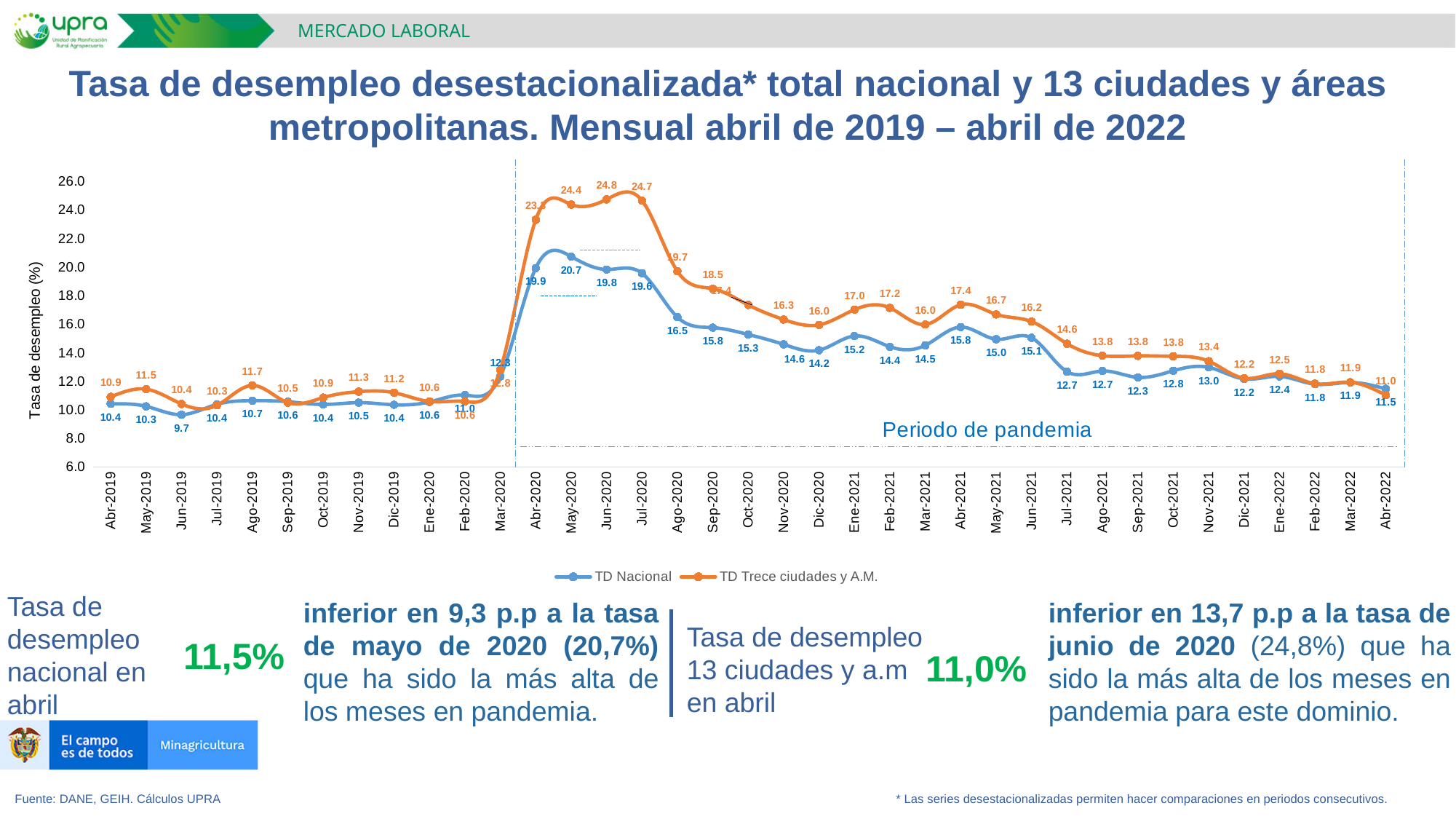
How many series does the legend list? 2 Is the value of TD Nacional in Ago-2020 greater or less than 18.0? less In which month does TD Nacional reach its highest value? May-2020 What is the difference between TD Trece ciudades y A.M. and TD Nacional in May-2020? 3.7 In which month does TD Nacional reach its lowest value? Jun-2019 In which month does TD Trece ciudades y A.M. reach its highest value? Jun-2020 What label is written inside the dashed box on the right part of the chart? Periodo de pandemia Which series has the higher value in Abr-2022, TD Nacional or TD Trece ciudades y A.M.? TD Nacional What is the value of TD Nacional in Abr-2022? 11.5 What type of chart is shown on the slide? line chart What is the value of TD Trece ciudades y A.M. in Jun-2020? 24.8 What is the value of TD Trece ciudades y A.M. in Ago-2019? 11.7